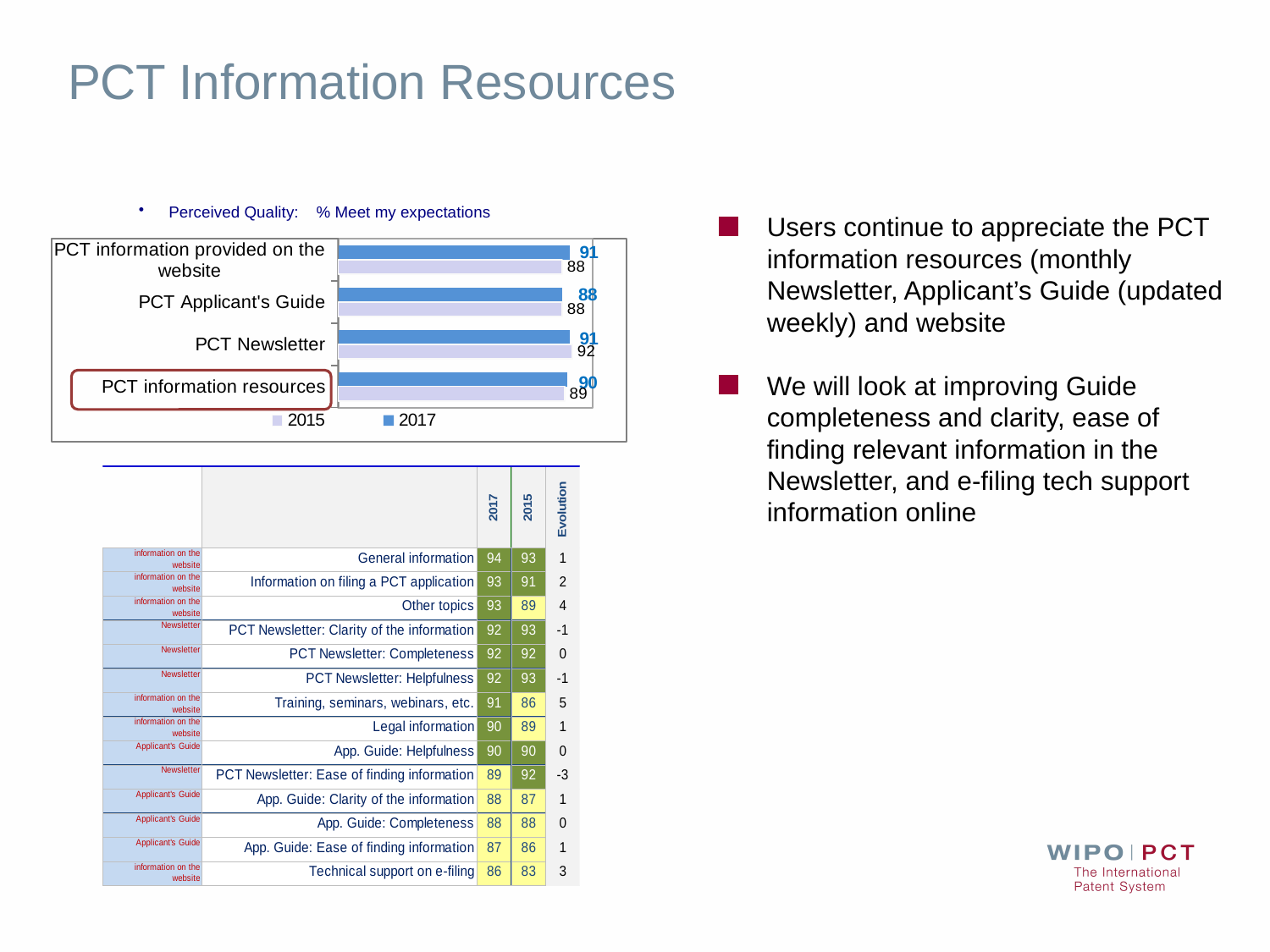
What is the 2017 value for PCT information provided on the website? 91 What is the difference between the 2017 and 2015 values for PCT information provided on the website? 3 Which series is shown in the darker blue bars in the chart? 2017 For PCT Newsletter, which is larger: the 2015 value or the 2017 value? 2015 How many categories are shown in the bar chart? 4 What is the 2015 value for PCT information resources? 89 Which category has the lowest 2017 value? PCT Applicant's Guide What type of chart is shown on the slide? bar chart How many series does the chart legend list? 2 What is the 2015 value for PCT Newsletter? 92 What is the 2017 value for PCT Applicant's Guide? 88 Which category has the highest 2015 value? PCT Newsletter